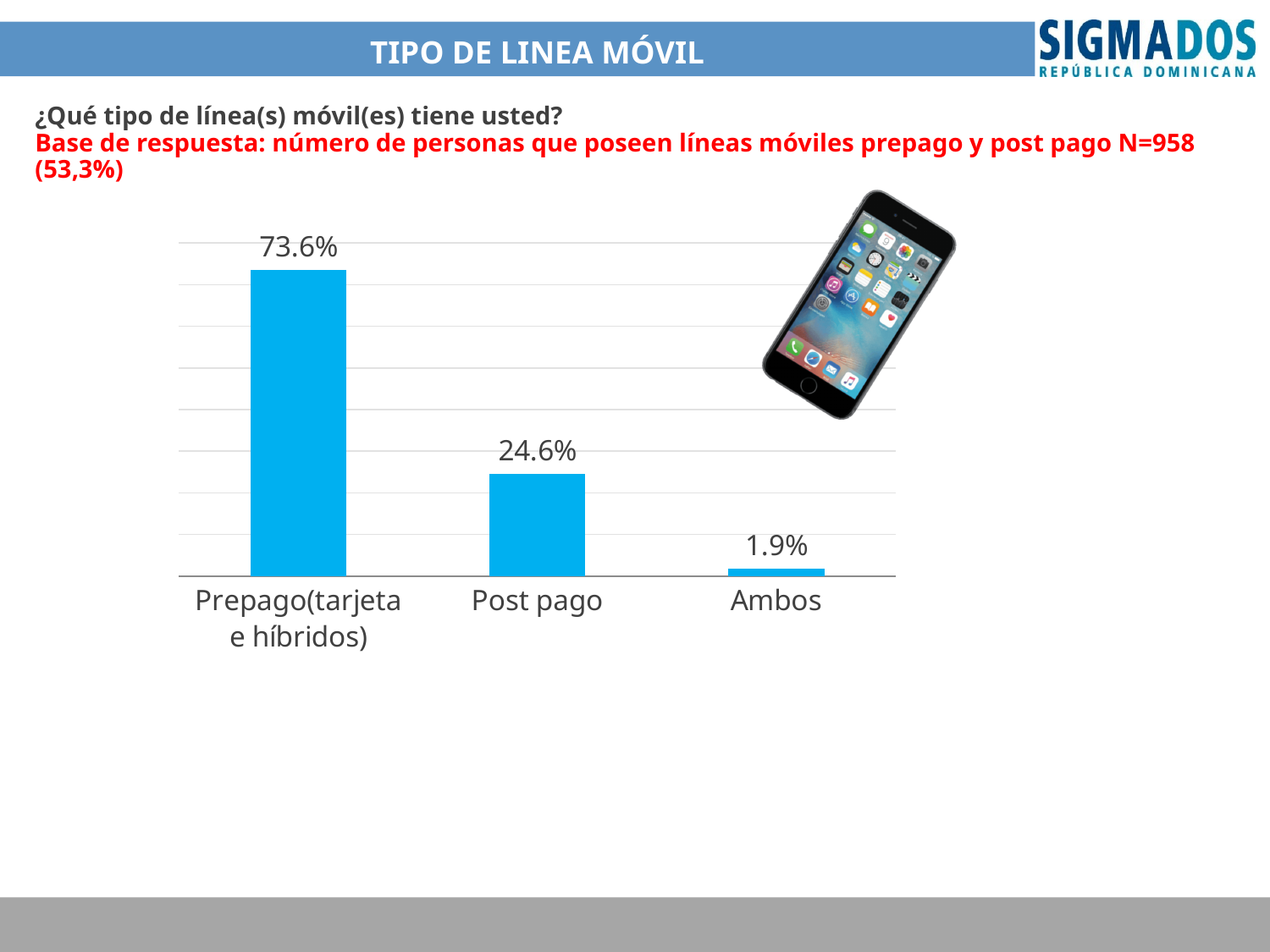
How many categories are shown in the chart? 3 What is the difference between the values for Prepago(tarjeta e híbridos) and Post pago? 49.0% What kind of chart is shown on the slide? Bar chart Which is larger, the value for Post pago or the value for Ambos? Post pago What is the value for Prepago(tarjeta e híbridos)? 73.6% What is the value for Post pago? 24.6% Which category has the highest value? Prepago(tarjeta e híbridos) What is the difference between the values for Post pago and Ambos? 22.7% What is the value for Ambos? 1.9% Which category has the lowest value? Ambos Do the values rise or fall from left to right across the categories? Fall What is the title of the slide containing the chart? TIPO DE LINEA MÓVIL